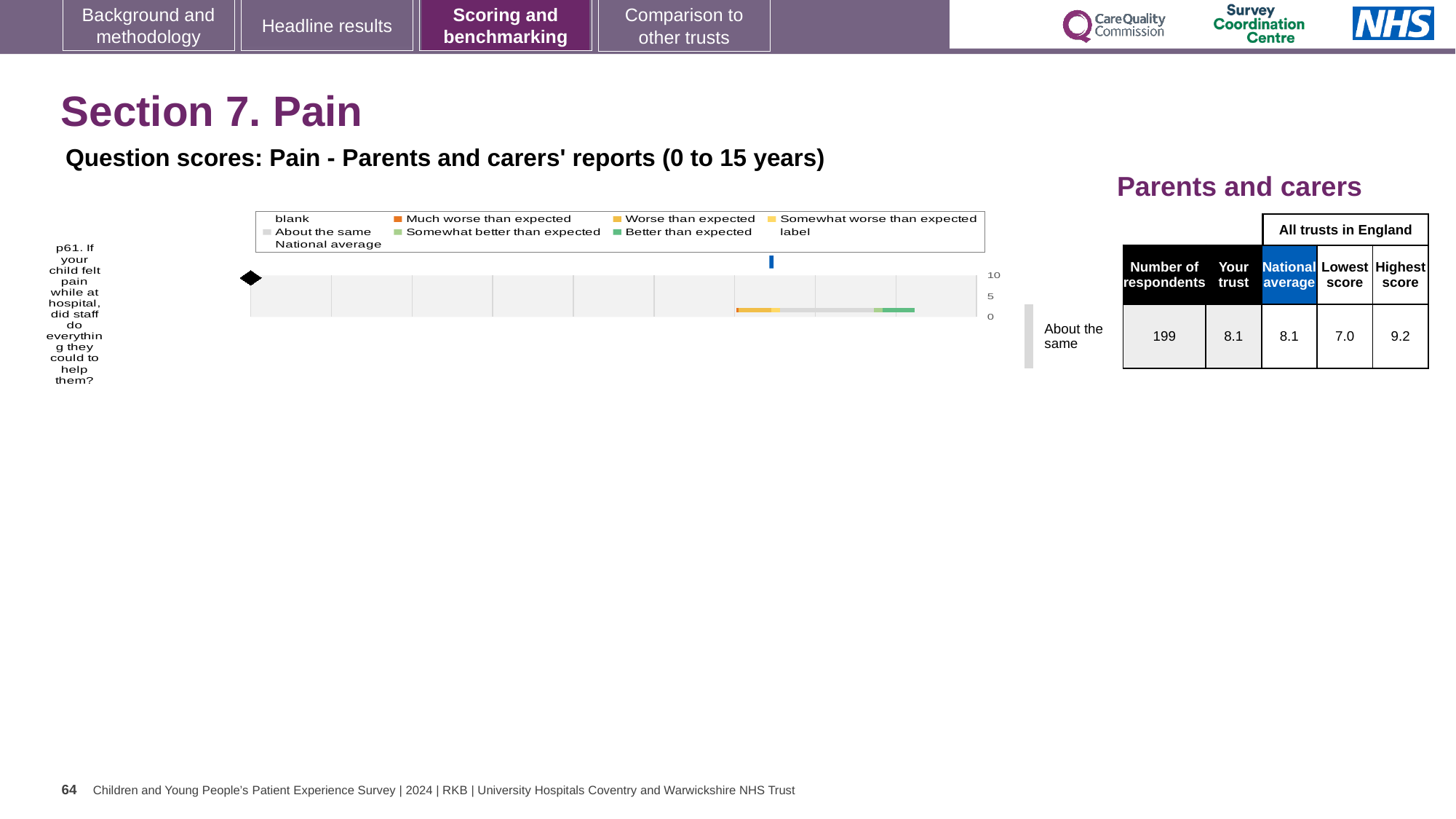
What is the difference between the highest and lowest trust scores for question p61? 2.2 Is the trust's score for question p61 greater or less than 5 on the chart's axis? greater What colour does the chart legend use for 'Better than expected'? Green How many respondents answered question p61? 199 How many survey questions are plotted in the chart? 1 What is the lowest score among all trusts in England for question p61? 7.0 Which benchmarking category is the trust's result for question p61 placed in? About the same What is the 'Your trust' score for question p61 about staff helping a child in pain? 8.1 What kind of chart is used to show the question score for p61? Bar chart What is the national average score for question p61 shown on the slide? 8.1 What is the highest score among all trusts in England for question p61? 9.2 Which is larger for question p61: the highest score or the lowest score across all trusts in England? Highest score